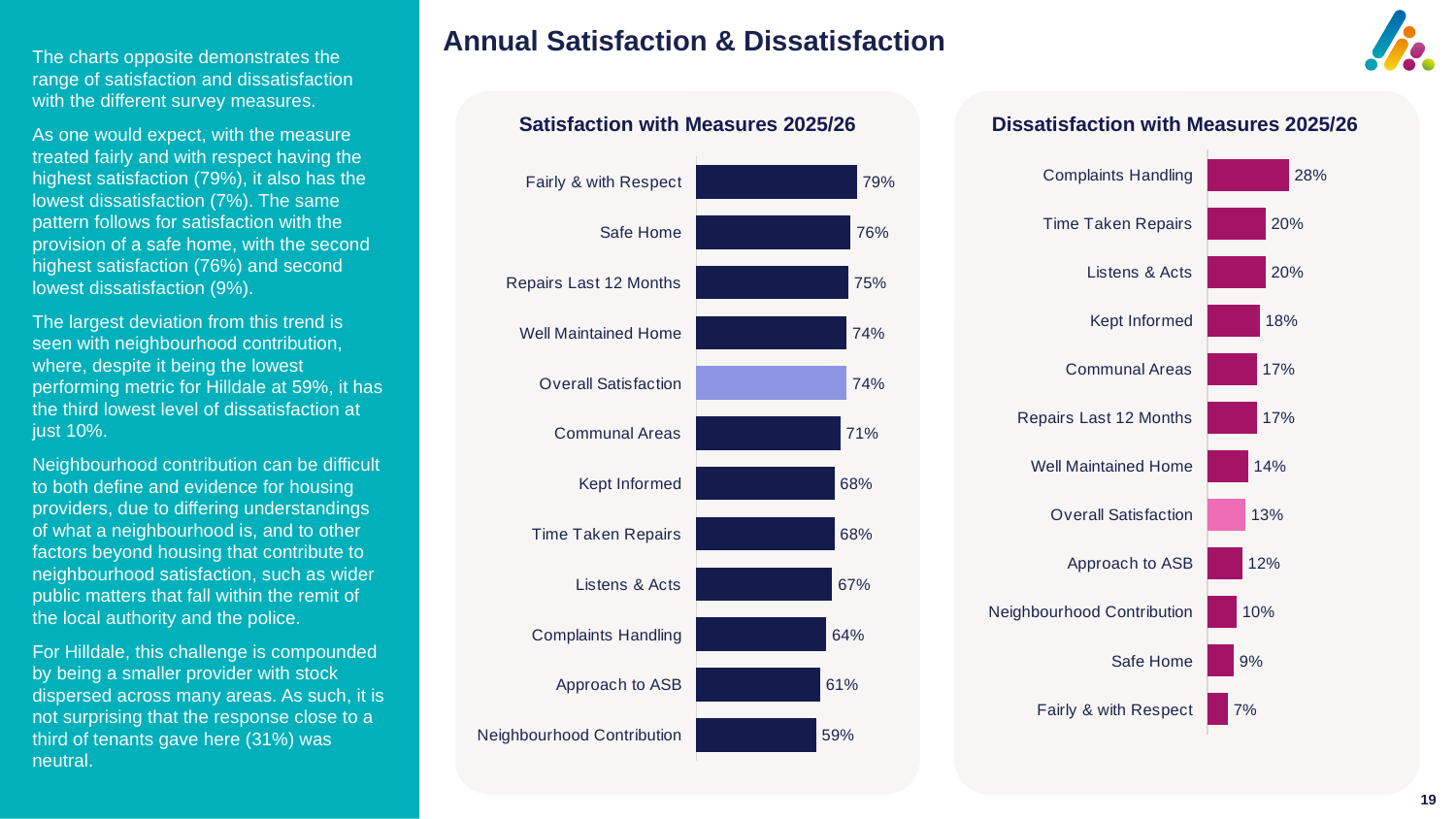
In the 'Dissatisfaction with Measures 2025/26' chart, what is the value for Kept Informed? 18% In the 'Satisfaction with Measures 2025/26' chart, what is the difference between Fairly & with Respect and Neighbourhood Contribution? 20% In the 'Dissatisfaction with Measures 2025/26' chart, which category's bar is shown in a lighter pink colour than the others? Overall Satisfaction In the 'Satisfaction with Measures 2025/26' chart, which category has the highest value? Fairly & with Respect How many categories are shown in the 'Dissatisfaction with Measures 2025/26' chart? 12 In the 'Satisfaction with Measures 2025/26' chart, which is larger: Communal Areas or Complaints Handling? Communal Areas What kind of chart is the 'Satisfaction with Measures 2025/26' chart? Bar chart In the 'Dissatisfaction with Measures 2025/26' chart, which category has the highest value? Complaints Handling In the 'Dissatisfaction with Measures 2025/26' chart, what is the difference between Complaints Handling and Overall Satisfaction? 15% In the 'Satisfaction with Measures 2025/26' chart, what is the value for Safe Home? 76% In the 'Satisfaction with Measures 2025/26' chart, which category has the lowest value? Neighbourhood Contribution In the 'Dissatisfaction with Measures 2025/26' chart, which category has the lowest value? Fairly & with Respect